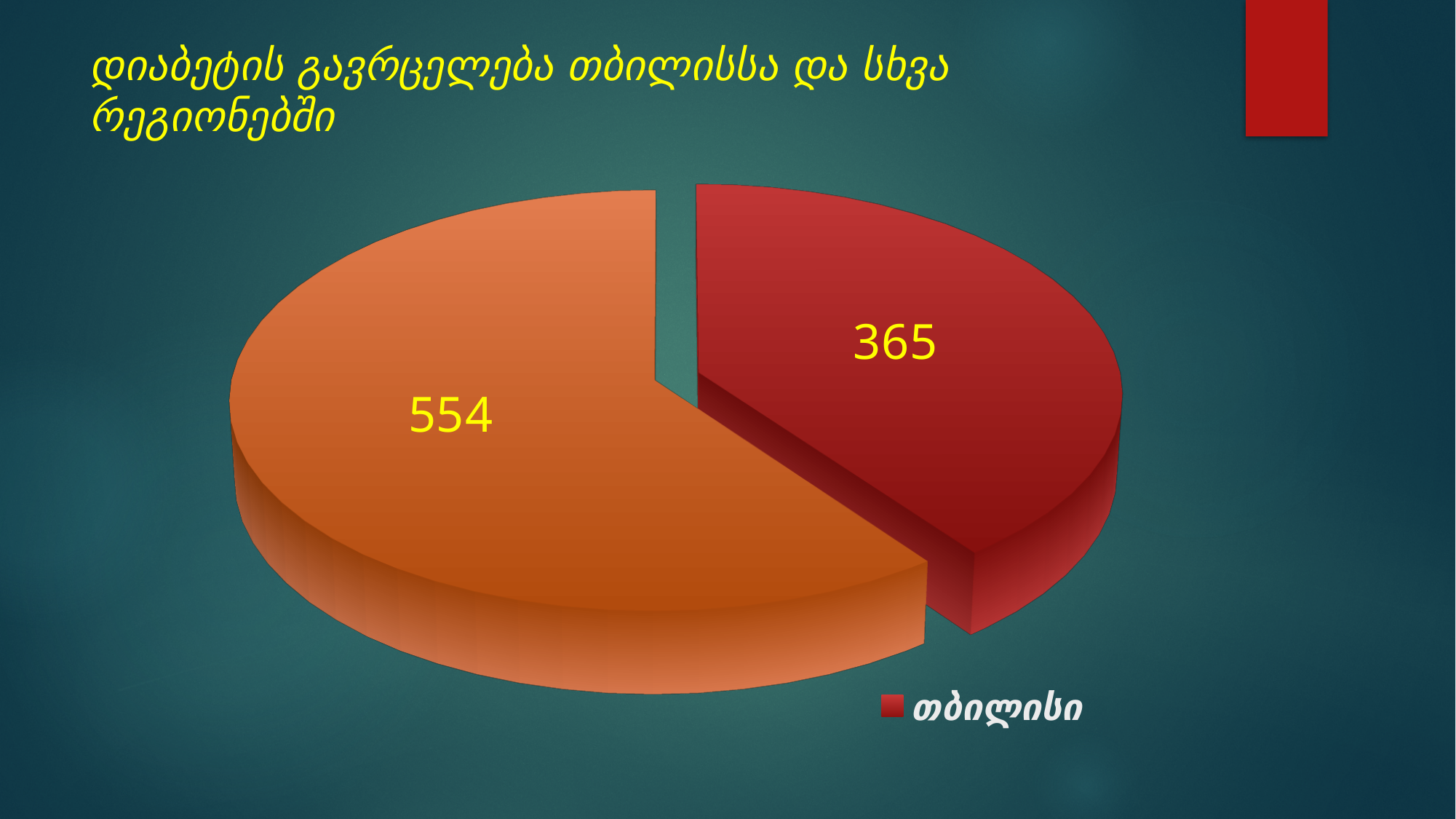
What is the total of the two values shown in the pie chart? 919 What value is printed on the orange slice of the pie chart? 554 What kind of chart is shown on the slide? pie chart Which slice is the largest in the pie chart, the red one or the orange one? the orange one Is the თბილისი slice the larger or the smaller slice of the pie? smaller What is the only entry listed in the chart legend? თბილისი How many entries does the chart legend list? 1 How many slices does the pie chart have? 2 What colour is the slice for თბილისი? red What is the difference between the two values shown in the pie chart, 554 and 365? 189 What value is shown for თბილისი in the pie chart? 365